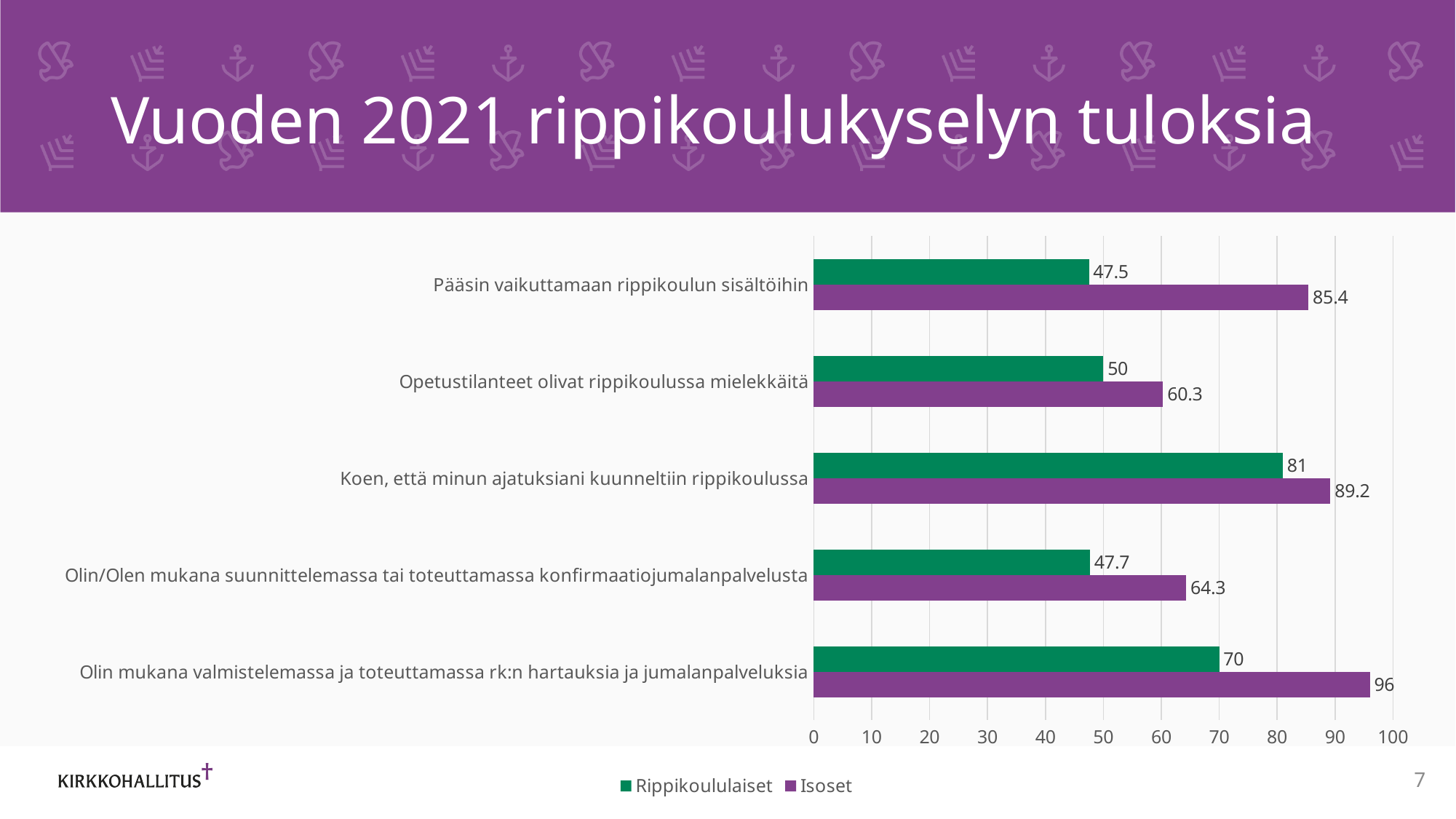
Which category has the lowest Rippikoululaiset value? Pääsin vaikuttamaan rippikoulun sisältöihin What is the Rippikoululaiset value for "Opetustilanteet olivat rippikoulussa mielekkäitä"? 50 Which colour represents the Isoset series? purple How many categories are shown on the chart? 5 What is the Rippikoululaiset value for "Koen, että minun ajatuksiani kuunneltiin rippikoulussa"? 81 Is the Isoset value for "Opetustilanteet olivat rippikoulussa mielekkäitä" greater or less than 70? less What is the difference between the Isoset and Rippikoululaiset values for "Pääsin vaikuttamaan rippikoulun sisältöihin"? 37.9 How many series does the legend list? 2 What kind of chart is shown on the slide? bar chart Which is larger for "Olin/Olen mukana suunnittelemassa tai toteuttamassa konfirmaatiojumalanpalvelusta": the Rippikoululaiset value or the Isoset value? Isoset What is the Isoset value for "Pääsin vaikuttamaan rippikoulun sisältöihin"? 85.4 Which category has the highest Isoset value? Olin mukana valmistelemassa ja toteuttamassa rk:n hartauksia ja jumalanpalveluksia